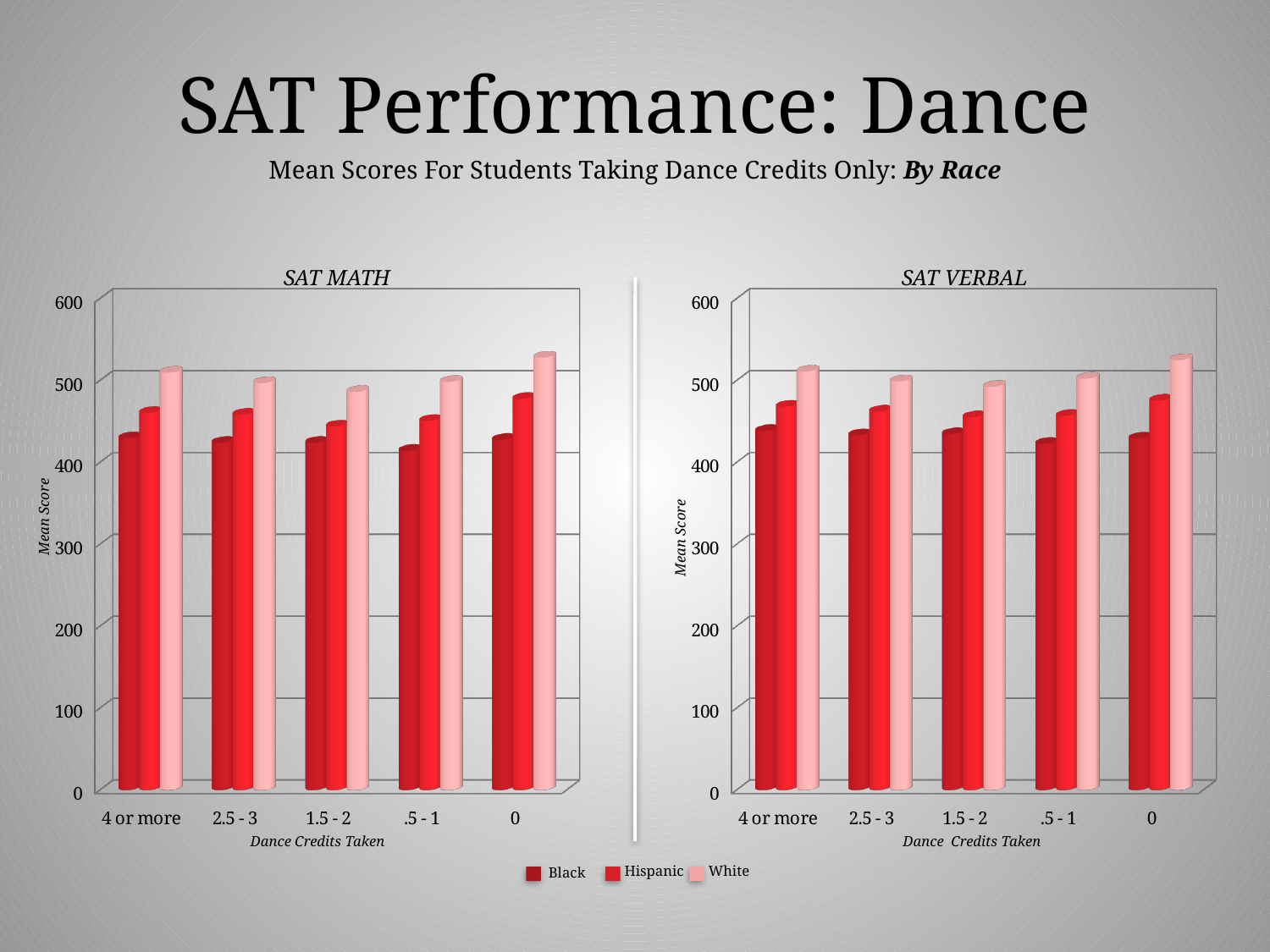
In the SAT MATH chart, which dance-credit category has the highest value for White students? 0 What kind of chart is the SAT MATH chart? bar chart How many series does the legend list for the charts? 3 In the SAT MATH chart, is the value for Black students with 4 or more dance credits greater or less than 500? less In the SAT VERBAL chart, is the value for Black students with .5 - 1 dance credits greater or less than 500? less In the SAT MATH chart, is the value for White students with 0 dance credits greater or less than 500? greater In the SAT VERBAL chart, for students with 1.5 - 2 dance credits, which is larger: the Hispanic value or the Black value? Hispanic What is the label on the y axis of the SAT VERBAL chart? Mean Score In the SAT MATH chart, for students with 4 or more dance credits, which is larger: the Black value or the White value? White In the SAT VERBAL chart, which dance-credit category has the highest value for White students? 0 How many dance-credit categories are shown on the x axis of the SAT VERBAL chart? 5